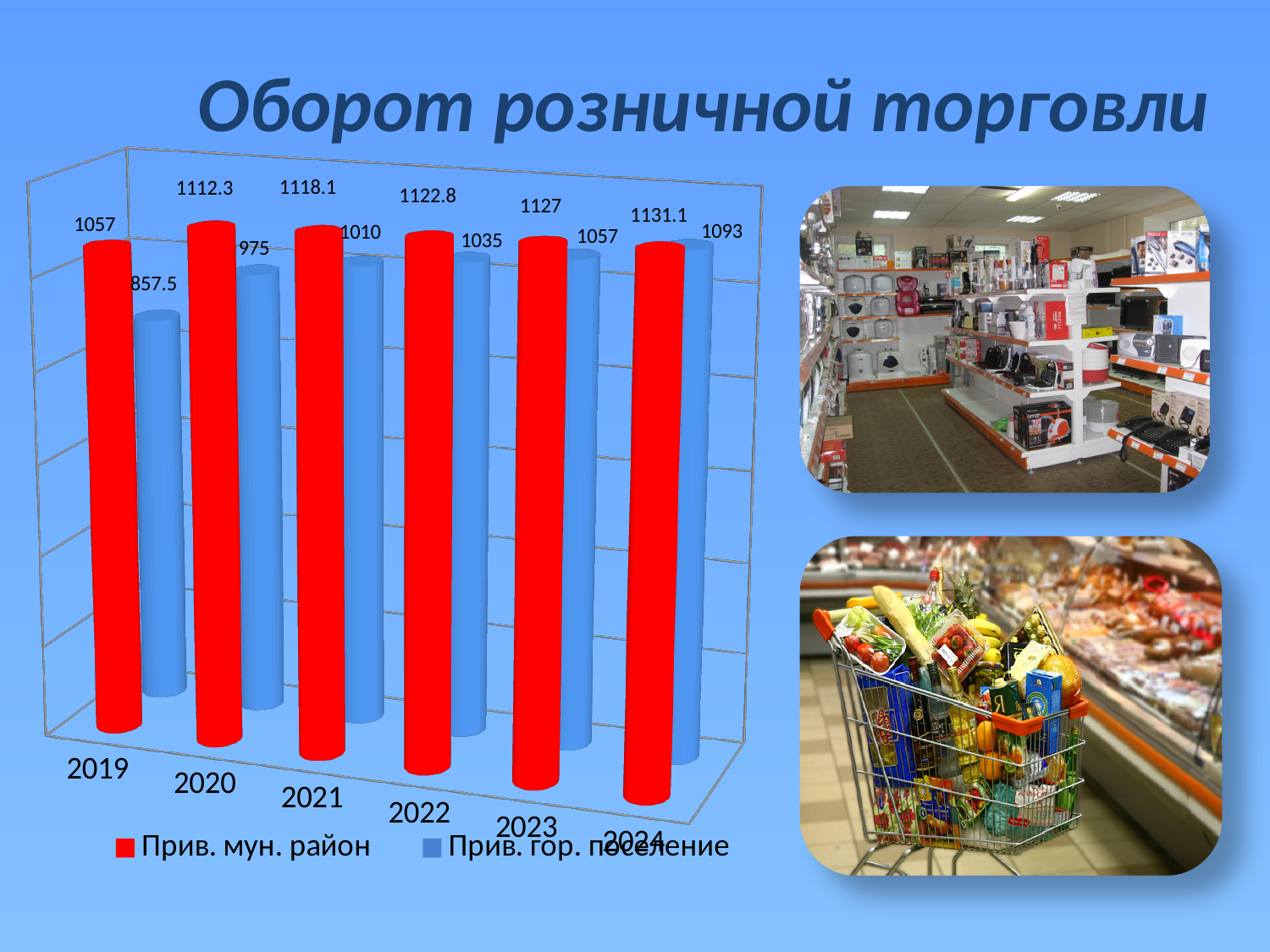
Do the values for Прив. гор. поселение rise or fall from 2019 to 2024? rise What is the value for Прив. мун. район in 2019? 1057 What is the value for Прив. гор. поселение in 2019? 857.5 What is the value for Прив. мун. район in 2024? 1131.1 How many years are shown on the x axis? 6 In which year is the value for Прив. гор. поселение the lowest? 2019 What is the value for Прив. гор. поселение in 2022? 1035 Which is larger in 2020: Прив. мун. район or Прив. гор. поселение? Прив. мун. район What is the difference between Прив. мун. район and Прив. гор. поселение in 2019? 199.5 How many series does the legend list? 2 What kind of chart is shown on the slide? bar chart In which year is the value for Прив. мун. район the highest? 2024